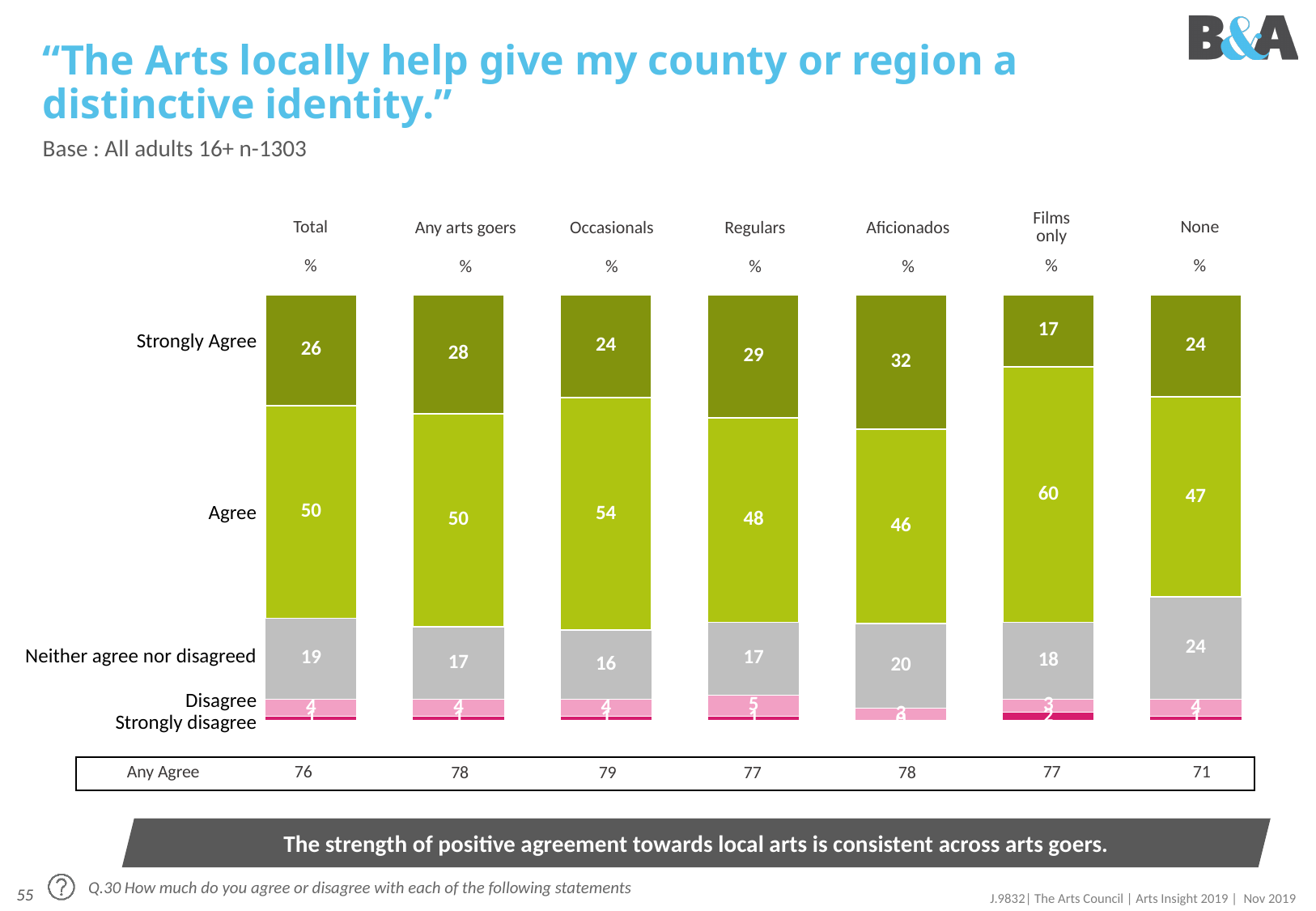
What is the Neither agree nor disagreed value for the None group? 24 What percentage of Aficionados strongly agree that the Arts locally help give their county or region a distinctive identity? 32 What type of chart is shown on the slide? Stacked bar chart What is the difference between the Strongly Agree values for Regulars and Occasionals? 5 Which group has the highest Strongly Agree value? Aficionados How many groups (bars) are shown in the chart? 7 Which group has the lowest Strongly Agree value? Films only What is the Agree value for the Films only group? 60 Which group has the highest Agree value? Films only What is the Any Agree value for Occasionals? 79 Which is larger: the Agree value for Occasionals or the Agree value for Aficionados? Occasionals According to the Any Agree row, which group has the lowest level of agreement? None